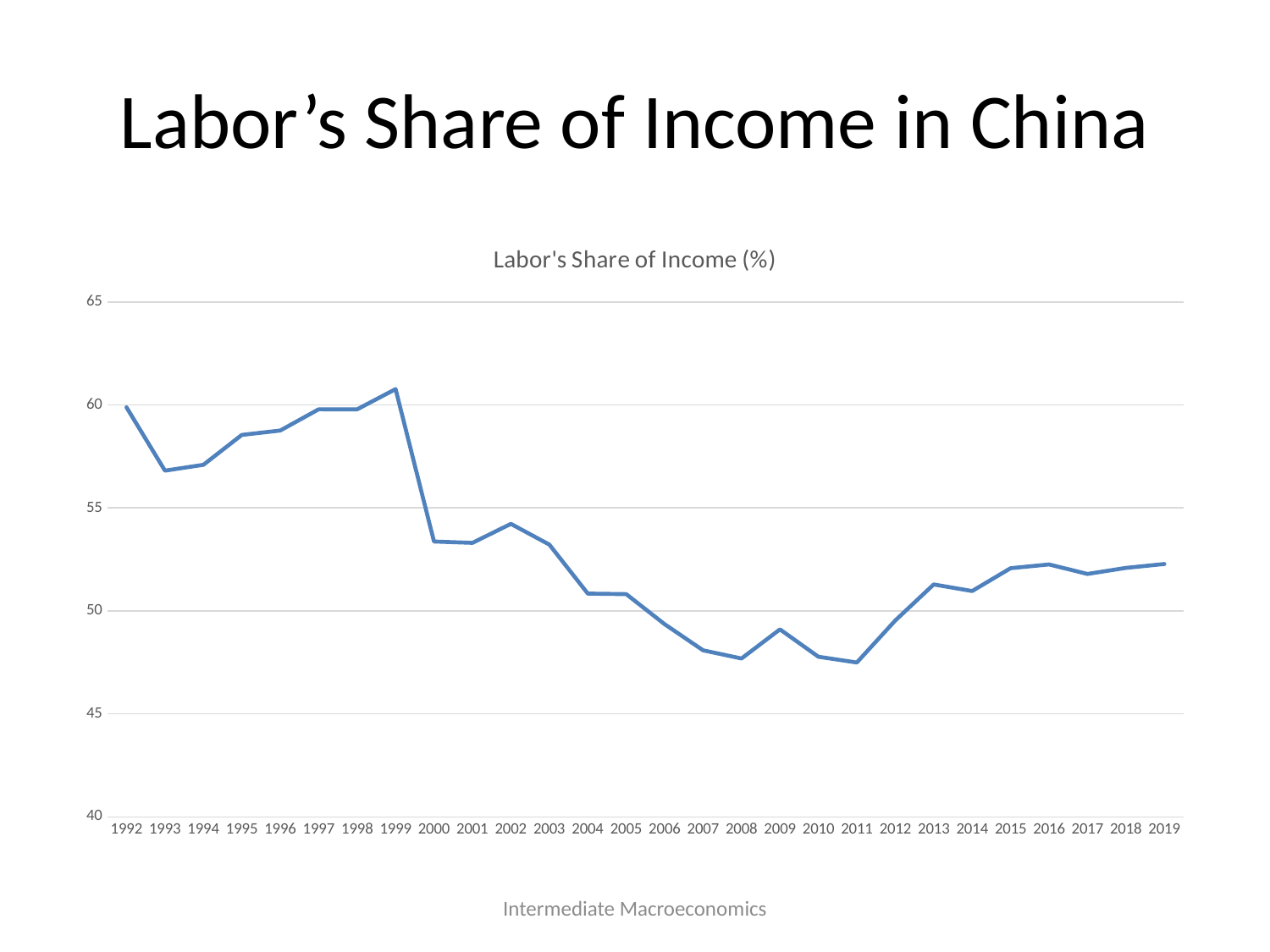
Which year has the larger value, 2011 or 2013? 2013 Which year has the larger value, 1992 or 2019? 1992 What is the title of the chart? Labor's Share of Income (%) Does labor's share of income rise or fall between 2011 and 2019? rise How many years are plotted along the x axis? 28 Is the value for 2019 greater or less than 50? greater What kind of chart is shown on the slide? line chart In which year is labor's share of income highest? 1999 Is the value for 1992 greater or less than 55? greater Is the value for 2007 greater or less than 50? less Does labor's share of income rise or fall between 1999 and 2011? fall